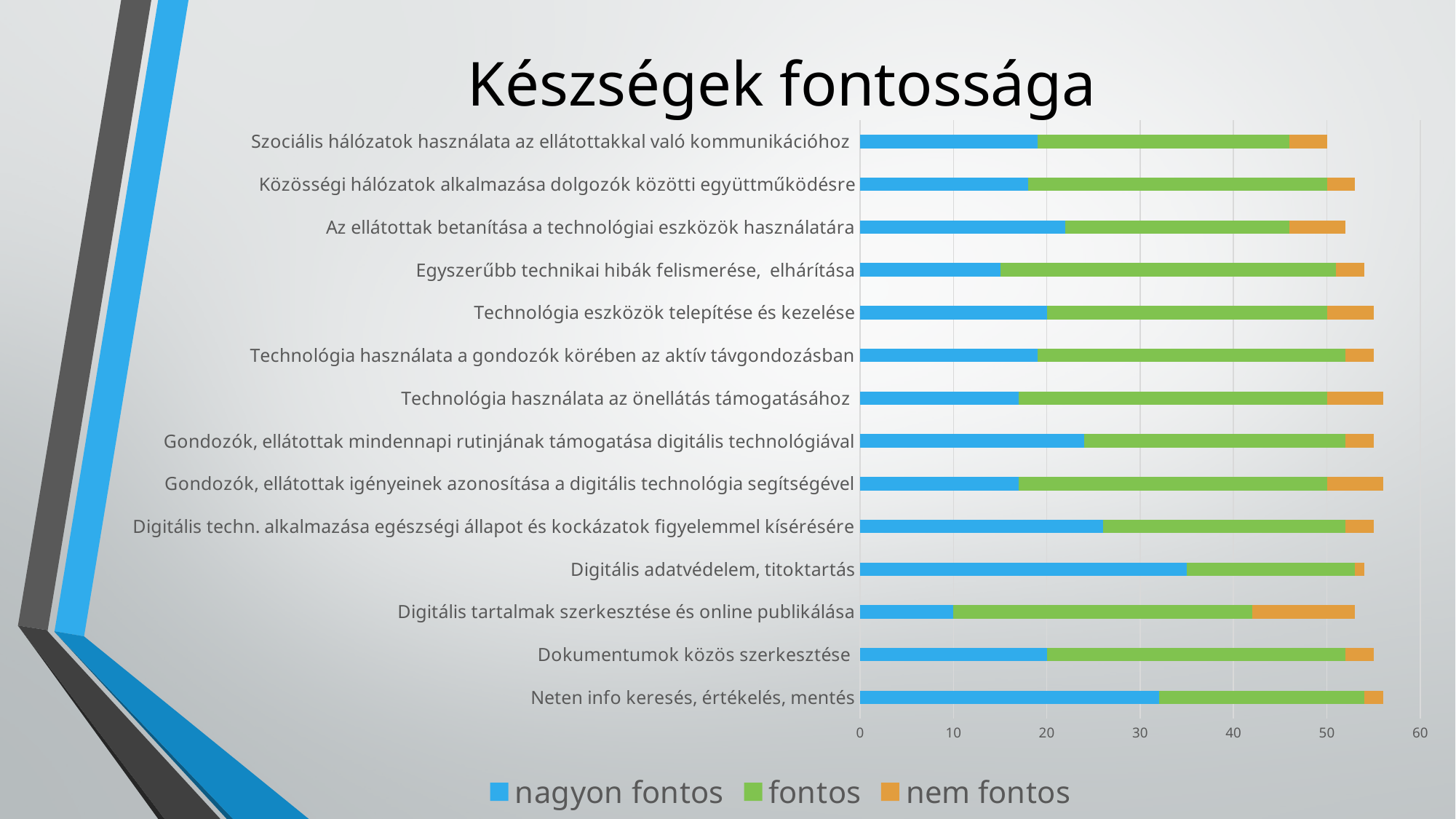
Which has a larger 'nem fontos' value: 'Digitális tartalmak szerkesztése és online publikálása' or 'Digitális adatvédelem, titoktartás'? Digitális tartalmak szerkesztése és online publikálása How many series does the legend list? 3 What is the title of the chart? Készségek fontossága Is the 'nagyon fontos' value for 'Digitális tartalmak szerkesztése és online publikálása' greater or less than 20? less Which category has the largest 'nem fontos' segment? Digitális tartalmak szerkesztése és online publikálása Is the 'nagyon fontos' value for 'Digitális adatvédelem, titoktartás' greater or less than 30? greater What kind of chart is shown on the slide? Stacked bar chart Which has a larger 'nagyon fontos' value: 'Neten info keresés, értékelés, mentés' or 'Egyszerűbb technikai hibák felismerése, elhárítása'? Neten info keresés, értékelés, mentés Which category has the smallest 'nagyon fontos' segment? Digitális tartalmak szerkesztése és online publikálása How many skill categories are plotted on the chart? 14 Which category has the largest 'nagyon fontos' segment? Digitális adatvédelem, titoktartás Which series is shown in orange in the legend? nem fontos